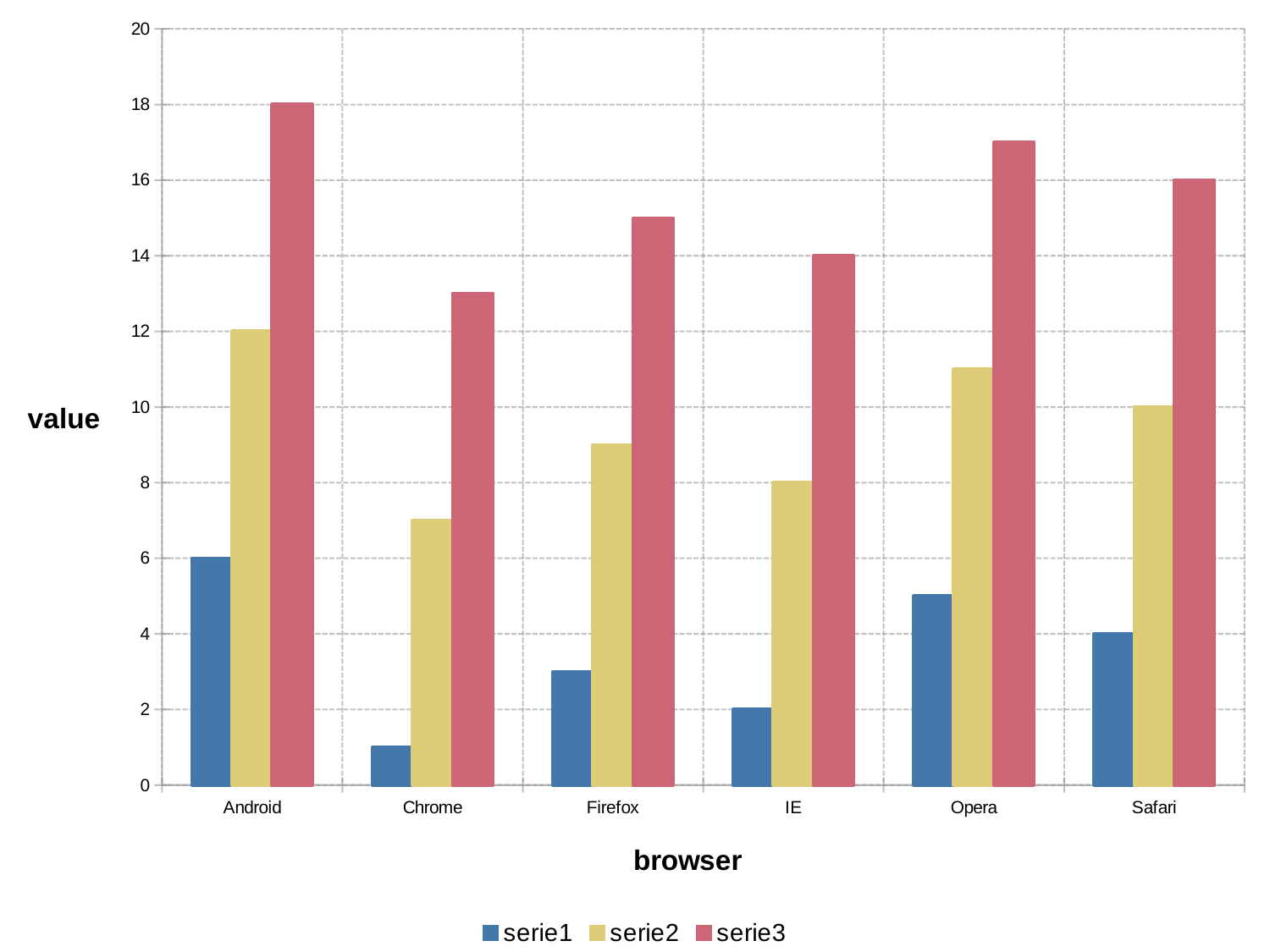
Which browser has the lowest serie1 value? Chrome Which is larger, the serie2 value for IE or the serie2 value for Safari? Safari How many series does the legend list? 3 What is the label of the y axis? value Which browser has the highest serie3 value? Android How many browsers are shown on the x axis? 6 What is the difference between the serie3 and serie1 values for Android? 12 What is the value of serie2 for Safari? 10 What is the value of serie3 for Android? 18 What is the value of serie1 for IE? 2 What kind of chart is this? bar chart Is the serie3 value for Chrome greater or less than 12? greater